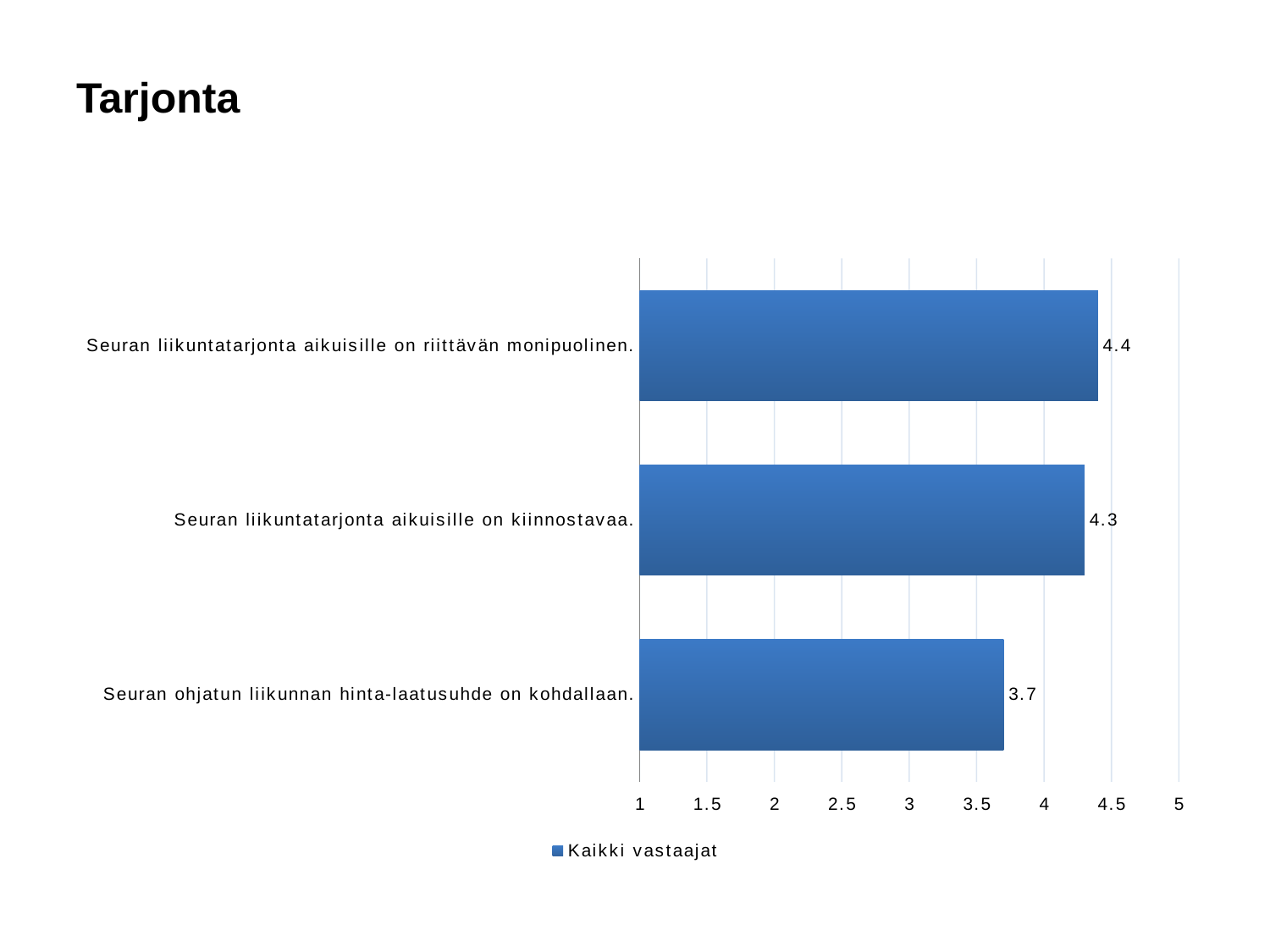
What is the difference between the values for "Seuran liikuntatarjonta aikuisille on riittävän monipuolinen." and "Seuran ohjatun liikunnan hinta-laatusuhde on kohdallaan."? 0.7 What is the value for "Seuran liikuntatarjonta aikuisille on riittävän monipuolinen."? 4.4 What is the difference between the values for "Seuran liikuntatarjonta aikuisille on kiinnostavaa." and "Seuran ohjatun liikunnan hinta-laatusuhde on kohdallaan."? 0.6 How many series does the legend list? 1 What is the value for "Seuran liikuntatarjonta aikuisille on kiinnostavaa."? 4.3 Is the value for "Seuran ohjatun liikunnan hinta-laatusuhde on kohdallaan." greater or less than 4? less Which category has the lowest value? Seuran ohjatun liikunnan hinta-laatusuhde on kohdallaan. How many categories are shown in the chart? 3 What kind of chart is shown on the slide? bar chart What is the value for "Seuran ohjatun liikunnan hinta-laatusuhde on kohdallaan."? 3.7 Which is larger: the value for "Seuran liikuntatarjonta aikuisille on kiinnostavaa." or the value for "Seuran ohjatun liikunnan hinta-laatusuhde on kohdallaan."? Seuran liikuntatarjonta aikuisille on kiinnostavaa. Which category has the highest value? Seuran liikuntatarjonta aikuisille on riittävän monipuolinen.